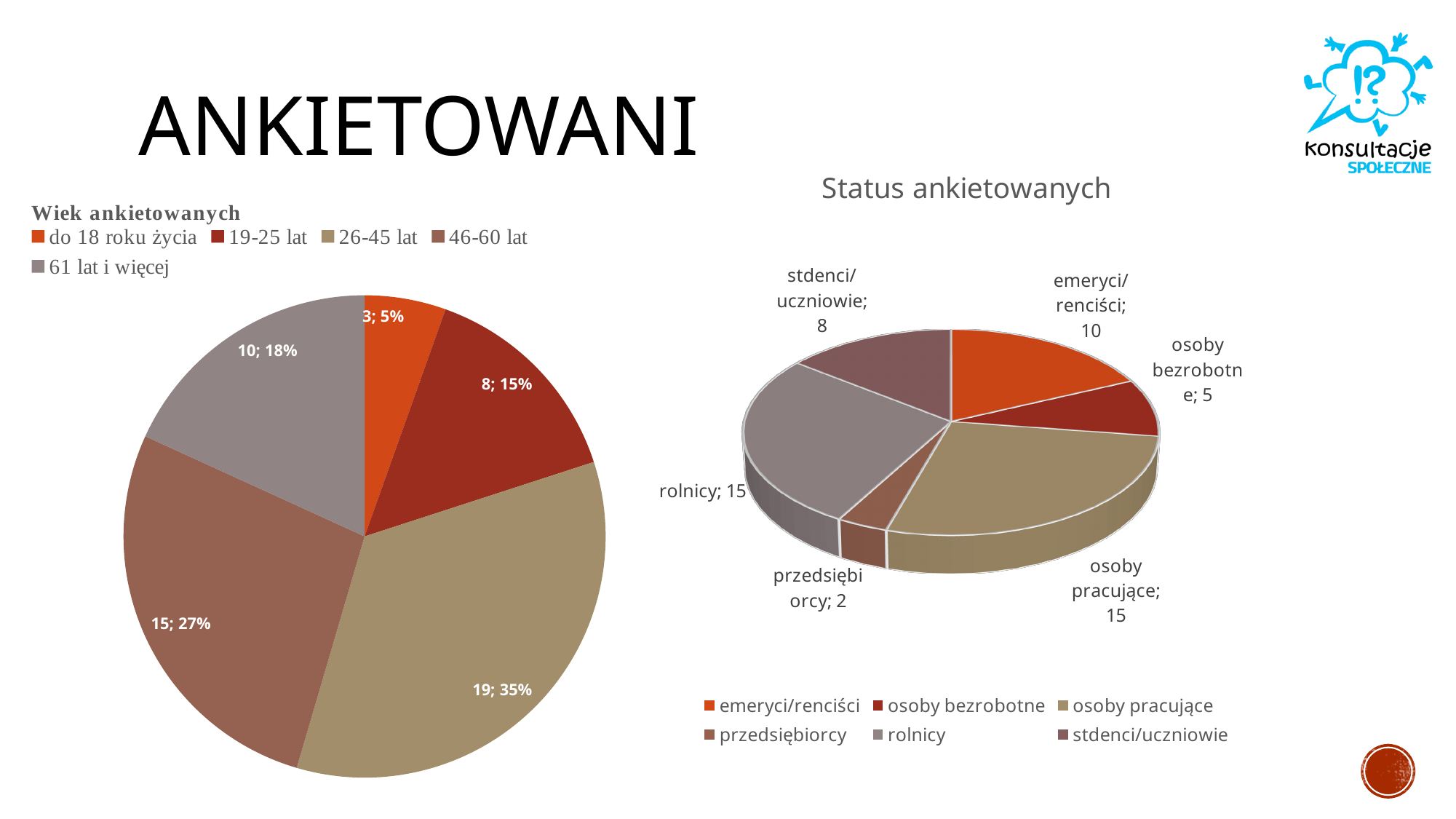
How many age groups does the legend of the 'Wiek ankietowanych' chart list? 5 In the 'Wiek ankietowanych' chart, which age group has the smallest slice? do 18 roku życia In the 'Status ankietowanych' chart, what is the value for stdenci/uczniowie? 8 In the 'Wiek ankietowanych' chart, what is the difference between the counts for 46-60 lat and 19-25 lat? 7 In the 'Status ankietowanych' chart, which category has the smallest value? przedsiębiorcy In the 'Status ankietowanych' chart, which is larger: emeryci/renciści or osoby bezrobotne? emeryci/renciści In the 'Wiek ankietowanych' chart, what percentage is shown for the 61 lat i więcej slice? 18% In the 'Wiek ankietowanych' chart, what value and percentage are shown for the 26-45 lat slice? 19; 35% What type of chart is the 'Status ankietowanych' chart? Pie chart How many categories are shown in the 'Status ankietowanych' chart? 6 In the 'Wiek ankietowanych' chart, which age group has the largest slice? 26-45 lat In the 'Status ankietowanych' chart, what is the value for osoby bezrobotne? 5